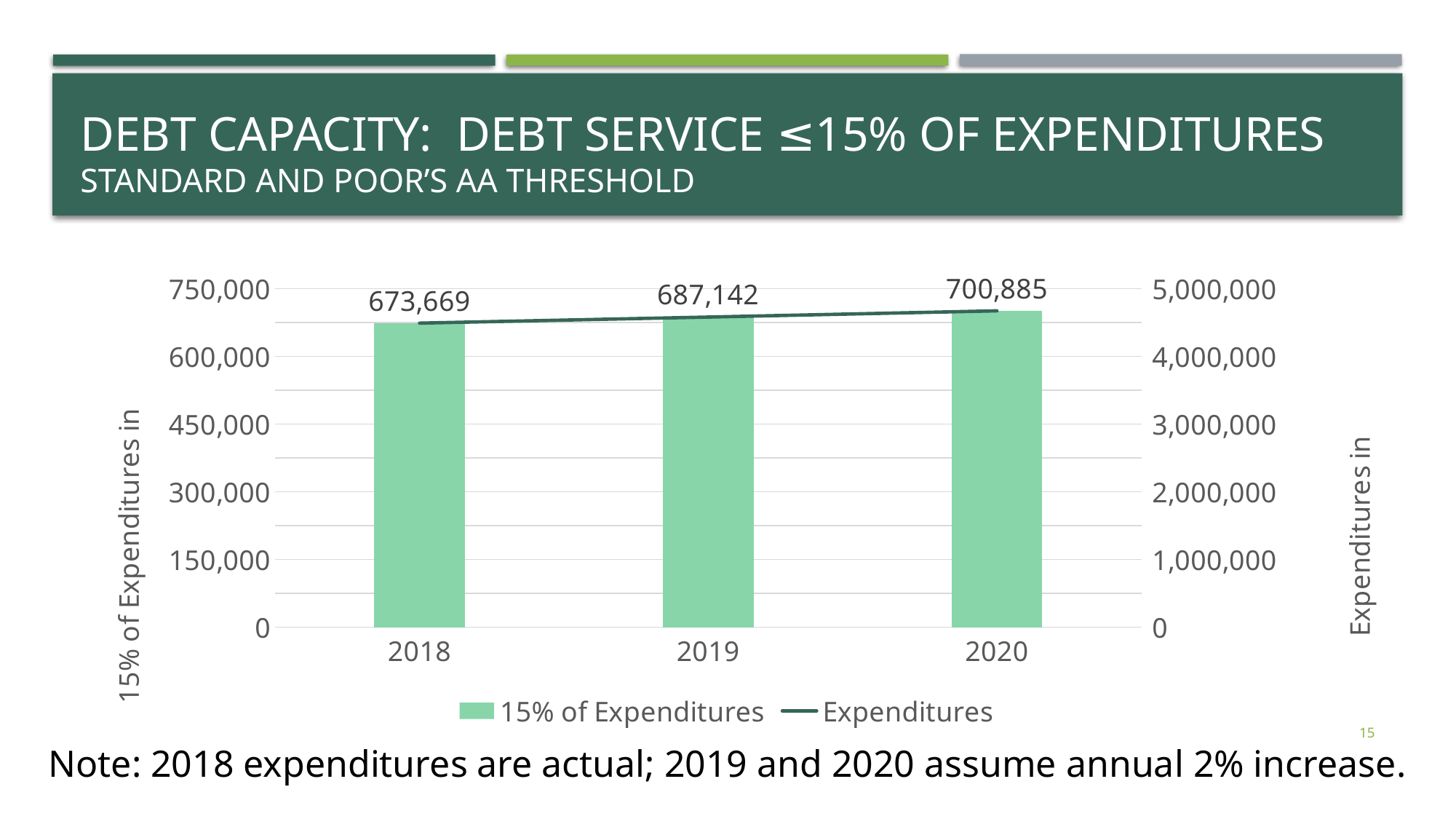
Which year has the lowest 15% of Expenditures value? 2018 Is the 15% of Expenditures value for 2019 larger or smaller than the value for 2020? smaller How many years are shown on the x axis of the chart? 3 What is the difference between the 15% of Expenditures values for 2019 and 2018? 13,473 What is the difference between the 15% of Expenditures values for 2020 and 2018? 27,216 Which year has the highest 15% of Expenditures value? 2020 What is the value of the 15% of Expenditures bar for 2020? 700,885 What is the value of the 15% of Expenditures bar for 2018? 673,669 Is the 15% of Expenditures value for 2018 greater or less than 600,000? greater Do the 15% of Expenditures values rise or fall from 2018 to 2020? rise What is the value of the 15% of Expenditures bar for 2019? 687,142 How many series does the chart legend list? 2